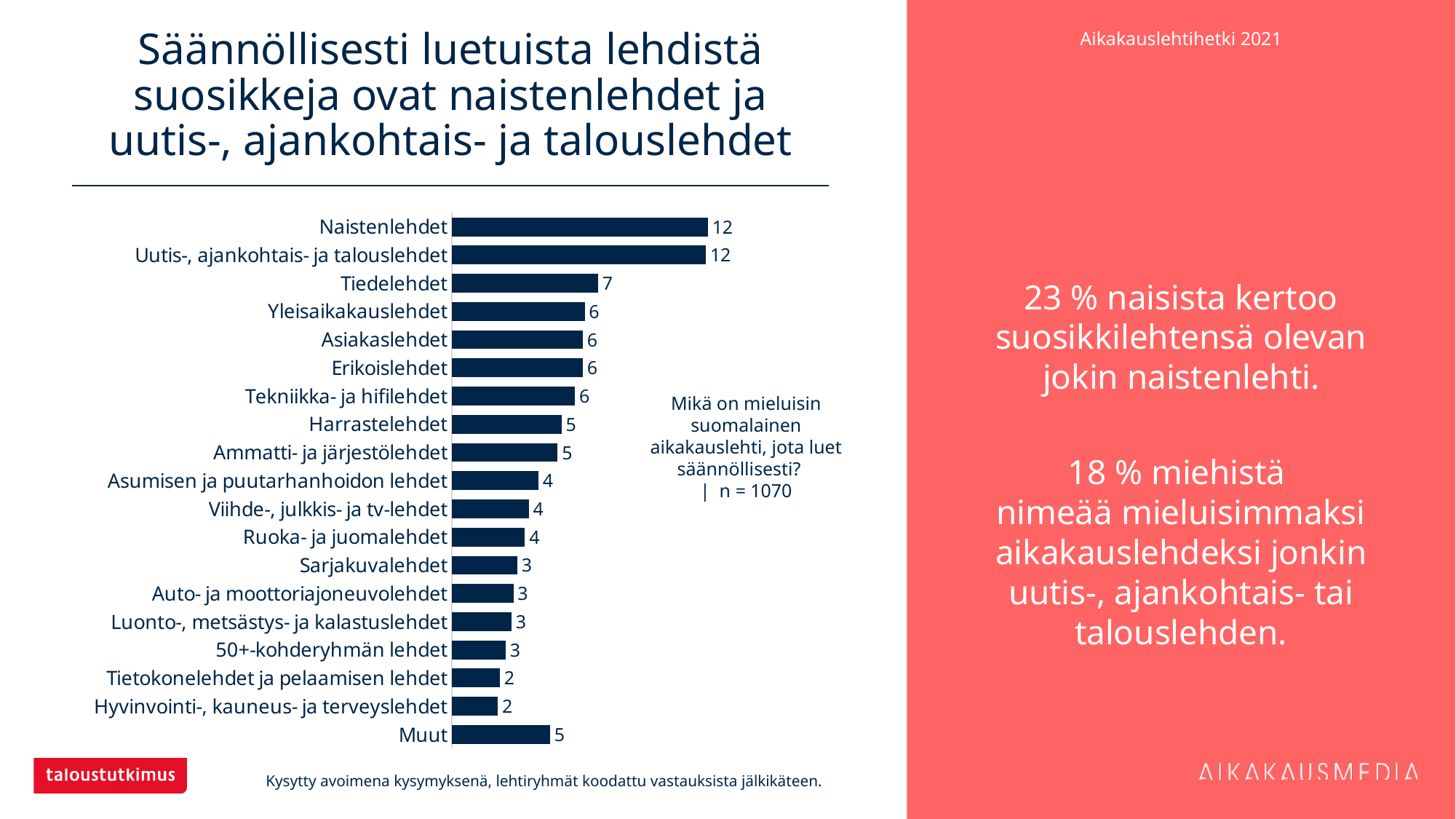
What type of chart is shown on the slide? Bar chart Which two categories share the highest value in the chart? Naistenlehdet and Uutis-, ajankohtais- ja talouslehdet What is the difference between the values for Naistenlehdet and Tiedelehdet? 5 What value is shown for Harrastelehdet? 5 What value is shown for Sarjakuvalehdet? 3 What value is shown for Hyvinvointi-, kauneus- ja terveyslehdet? 2 How many categories are shown in the bar chart? 19 What value is shown for Tiedelehdet? 7 What value is shown for Muut? 5 What is the sample size (n) stated next to the chart? n = 1070 Which has a larger value, Yleisaikakauslehdet or Ruoka- ja juomalehdet? Yleisaikakauslehdet What is the lowest value shown in the chart? 2